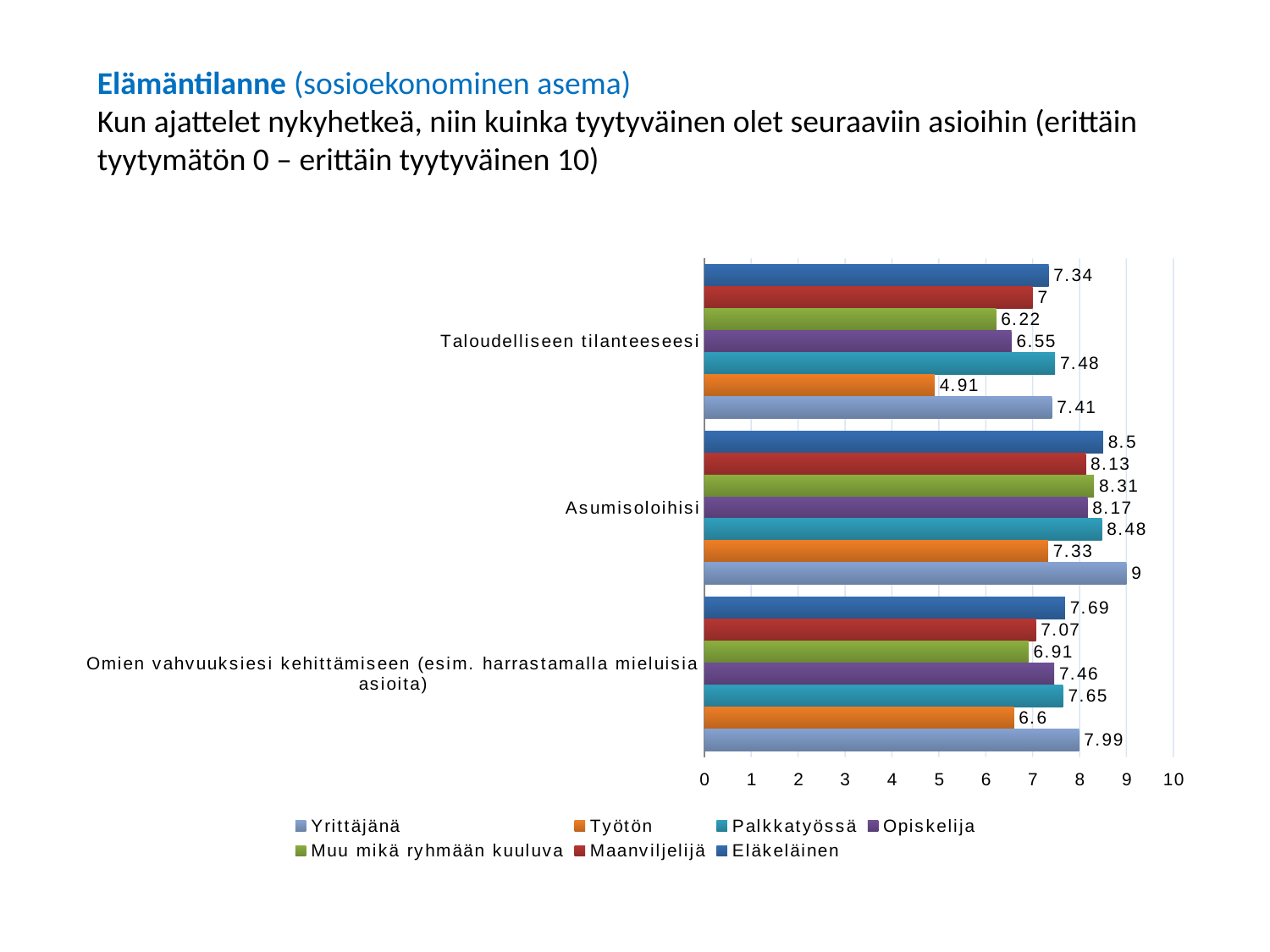
In the category Omien vahvuuksiesi kehittämiseen, which is larger: the value for Palkkatyössä or the value for Maanviljelijä? Palkkatyössä How many categories are shown on the vertical axis? 3 What is the value for Yrittäjänä in the category Asumisoloihisi? 9 What is the difference between the Yrittäjänä and Työtön values in the category Asumisoloihisi? 1.67 Which series has the lowest value in the category Taloudelliseen tilanteeseesi? Työtön Which series has the highest value in the category Asumisoloihisi? Yrittäjänä What is the value for Eläkeläinen in the category Omien vahvuuksiesi kehittämiseen? 7.69 How many series does the legend list? 7 What is the value for Työtön in the category Taloudelliseen tilanteeseesi? 4.91 What is the difference between the Palkkatyössä and Muu mikä ryhmään kuuluva values in the category Taloudelliseen tilanteeseesi? 1.26 Which series is shown in orange in the legend? Työtön What kind of chart is shown on the slide? bar chart